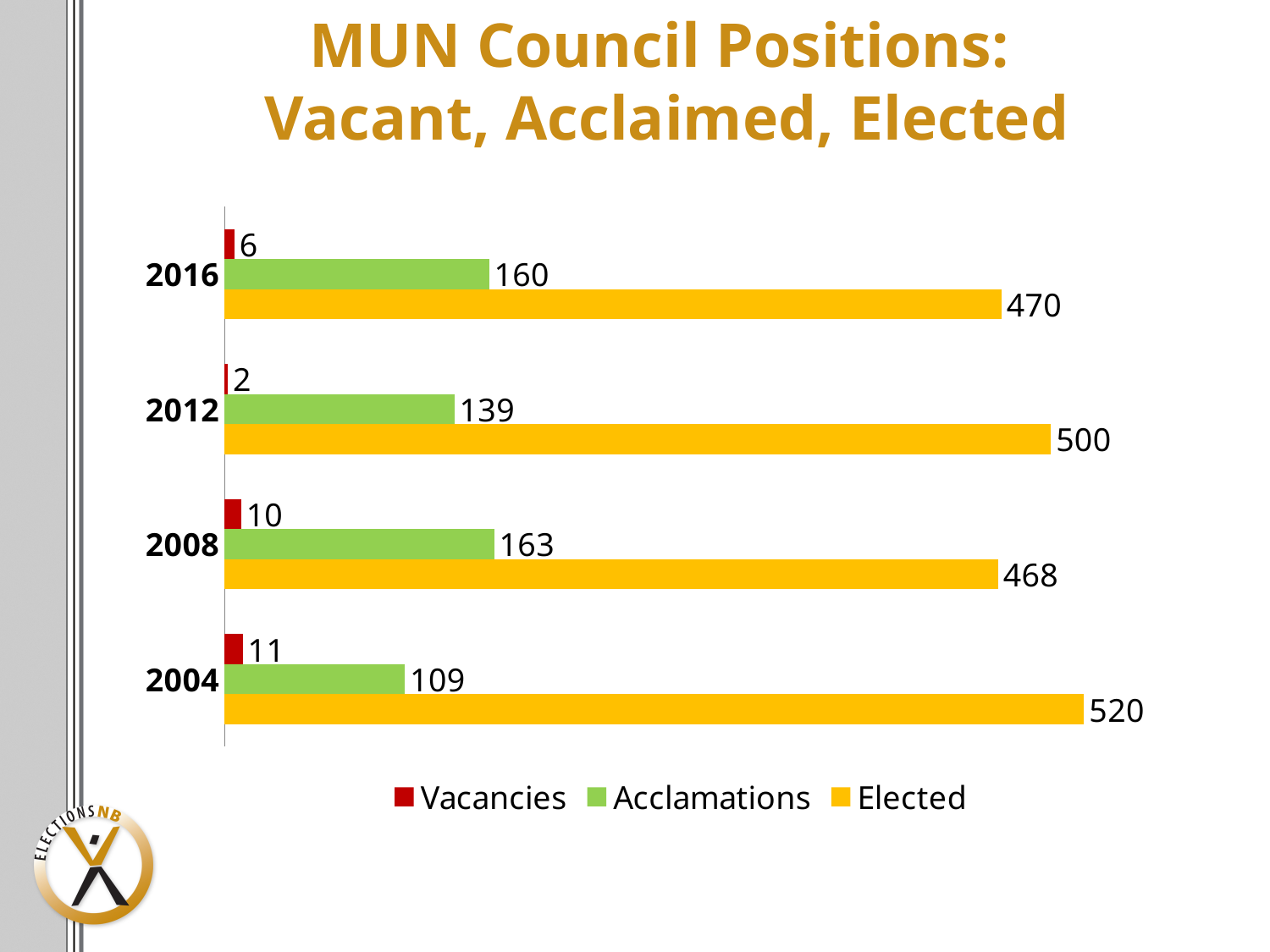
What is the difference between the Elected positions in 2004 and 2016? 50 Which is larger, the number of Acclamations in 2008 or in 2012? 2008 What kind of chart is shown on the slide? Bar chart Which colour represents the Acclamations series? Green How many years are shown on the chart? 4 How many series does the legend list? 3 Which year has the lowest number of Acclamations? 2004 Which year has the lowest number of Vacancies? 2012 Which year has the highest number of Elected positions? 2004 What is the number of Vacancies in 2016? 6 What is the number of Acclamations in 2004? 109 What is the number of Elected positions in 2012? 500